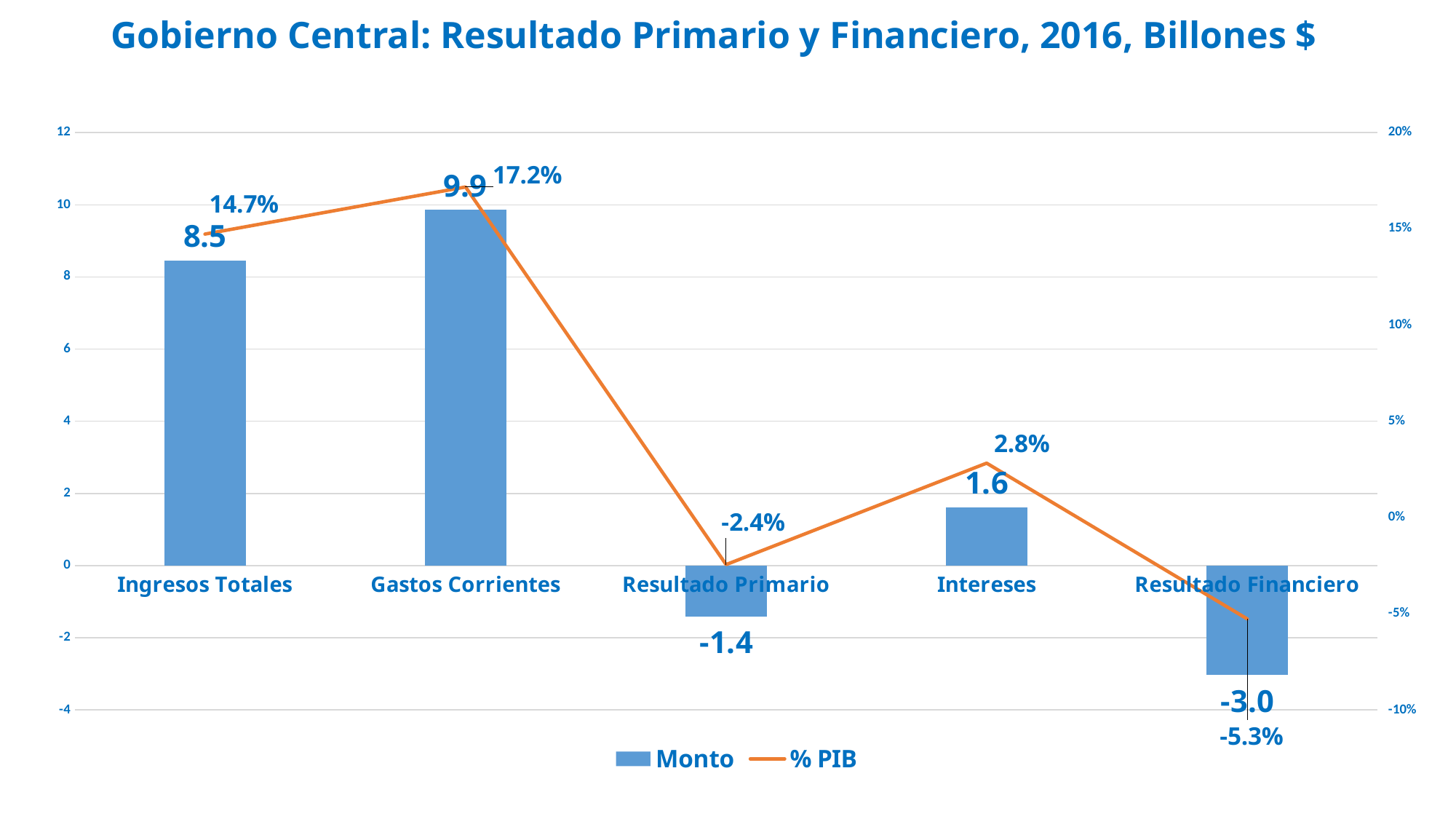
What is the % PIB value for Intereses? 2.8% What is the Monto value for Resultado Financiero? -3.0 What is the Monto value for Ingresos Totales? 8.5 What kind of chart is this? Combined bar and line chart How many categories are shown on the x axis? 5 What is the title of the chart? Gobierno Central: Resultado Primario y Financiero, 2016, Billones $ What is the % PIB value for Gastos Corrientes? 17.2% What is the difference between the Monto values for Gastos Corrientes and Ingresos Totales? 1.4 Which category has the highest Monto value? Gastos Corrientes How many series does the legend list? 2 Which category has the lowest % PIB value? Resultado Financiero Which is larger, the Monto value for Intereses or for Resultado Primario? Intereses